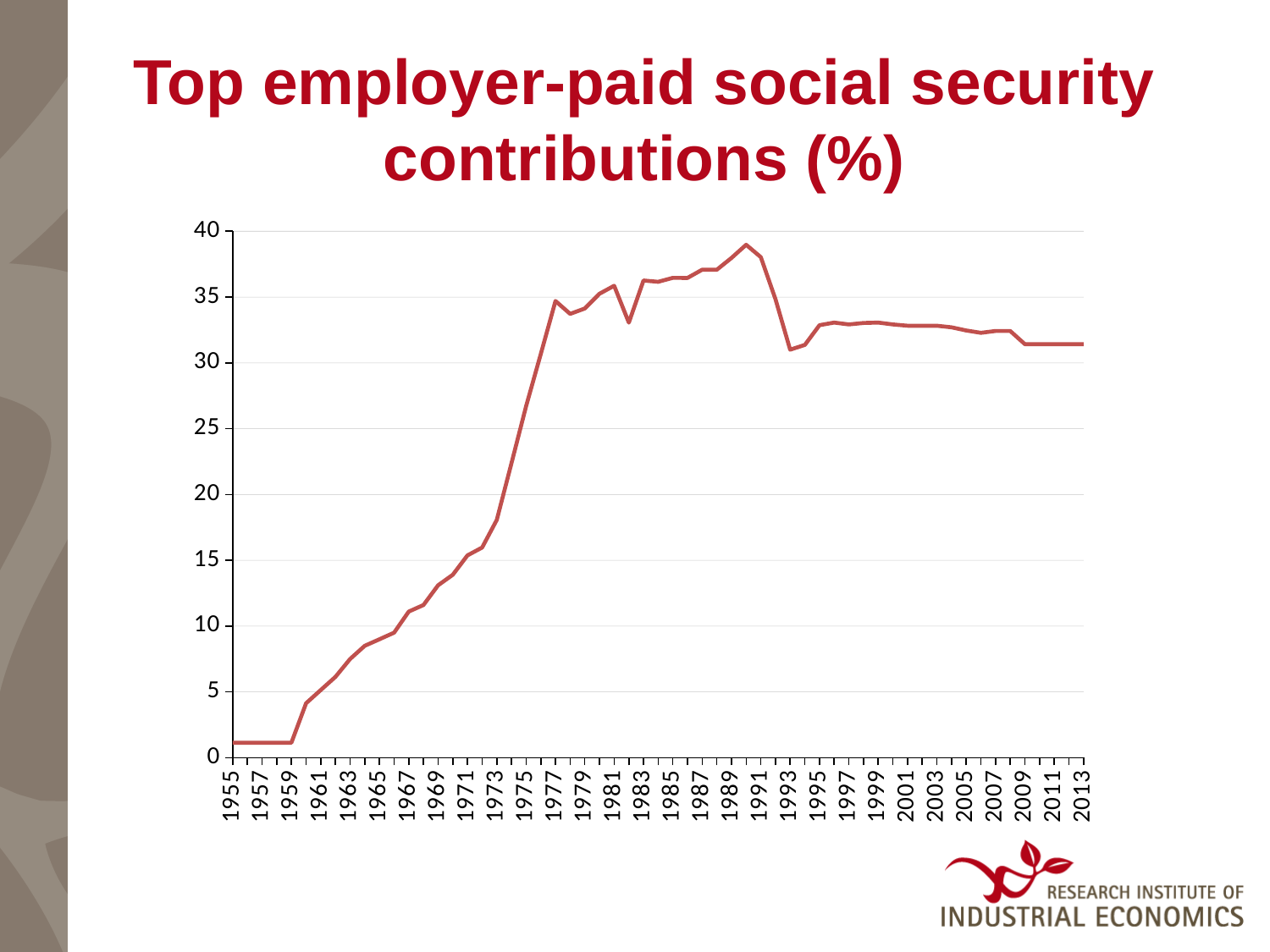
Is the value for 1965 greater or less than 10? less Is the value for 2013 greater or less than 35? less What is the title of the chart? Top employer-paid social security contributions (%) Is the value for 1959 greater or less than 5? less What kind of chart is shown on the slide? line chart Which year has the larger value, 1993 or 1995? 1995 Which year has the larger value, 1965 or 1977? 1977 Does the value rise or fall between 1959 and 1977? rise What is the first year shown on the x axis? 1955 Does the value rise or fall between 1991 and 1993? fall